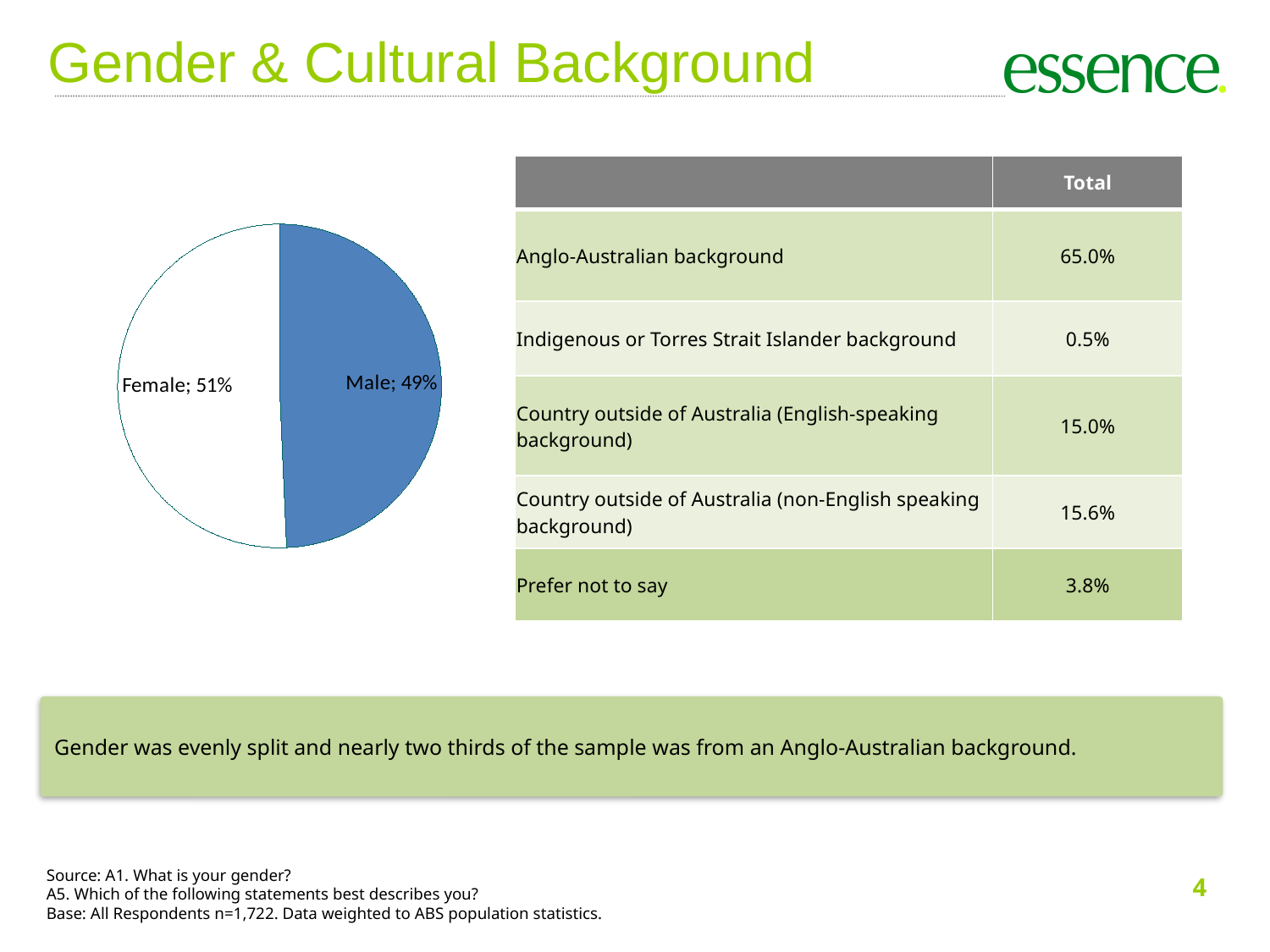
What type of chart is shown on the slide? pie chart Is the Male share in the pie chart greater or less than 50%? less Which slice of the pie chart is the largest? Female What is the difference between the Female and Male shares in the pie chart? 2% Which is larger in the pie chart, Female or Male? Female What colour is the Female slice of the pie chart? white What share of the pie chart is Female? 51% How many slices does the pie chart have? 2 Which slice of the pie chart is the smallest? Male What colour is the Male slice of the pie chart? blue What share of the pie chart is Male? 49%